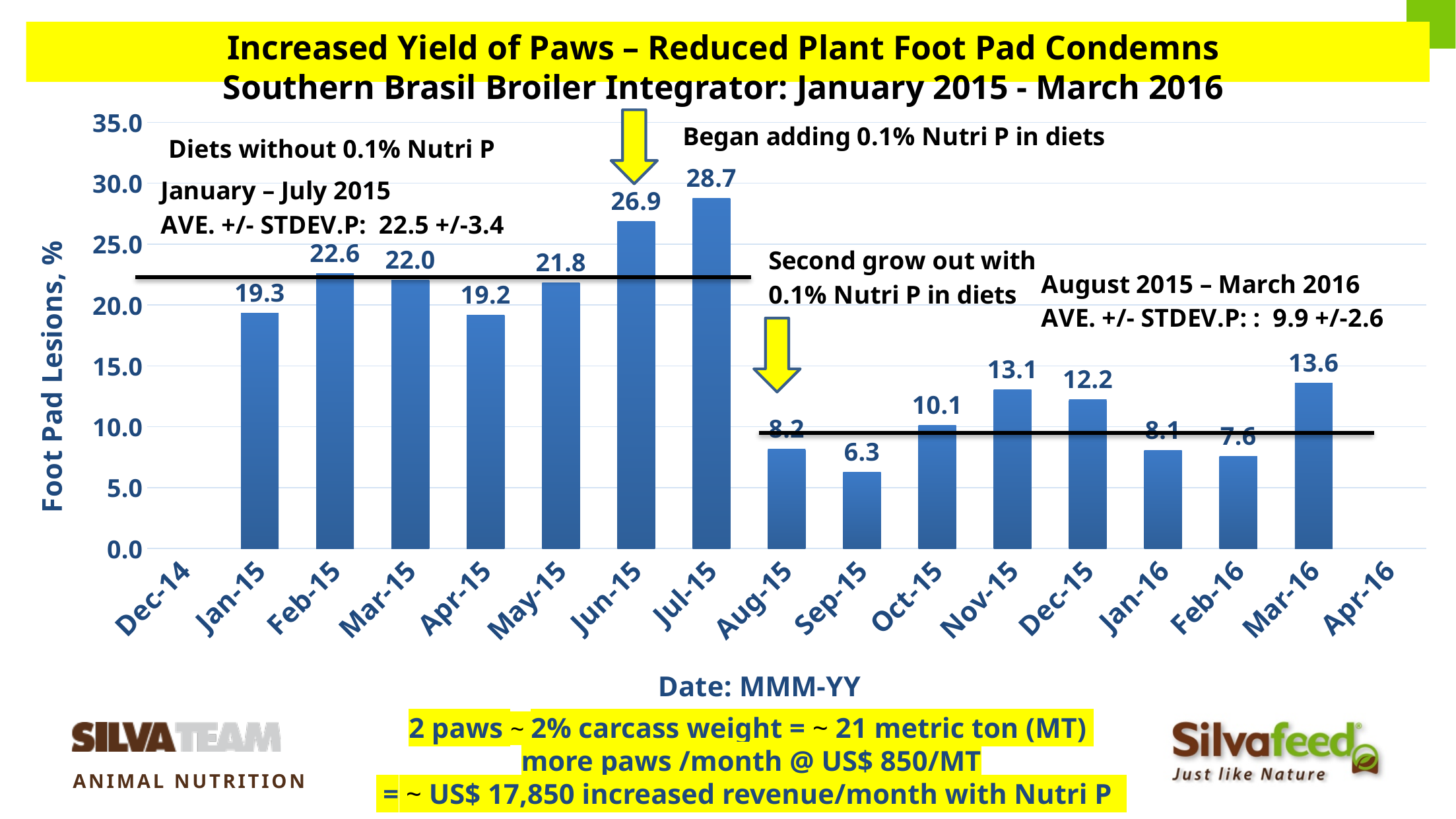
Is the value for Jun-15 greater or less than 25.0? greater Which is larger, the value for Nov-15 or the value for Dec-15? Nov-15 What is the label of the vertical axis? Foot Pad Lesions, % What is the difference between the values for Feb-15 and Mar-15? 0.6 What is the foot pad lesion value for Jul-15? 28.7 What is the value shown for Mar-16? 13.6 How many bars are plotted in the chart? 15 What is the difference between the values for Jul-15 and Aug-15? 20.5 What is the foot pad lesion value for Sep-15? 6.3 Which month has the highest foot pad lesion value? Jul-15 What type of chart is shown on the slide? bar chart Which month has the lowest foot pad lesion value? Sep-15